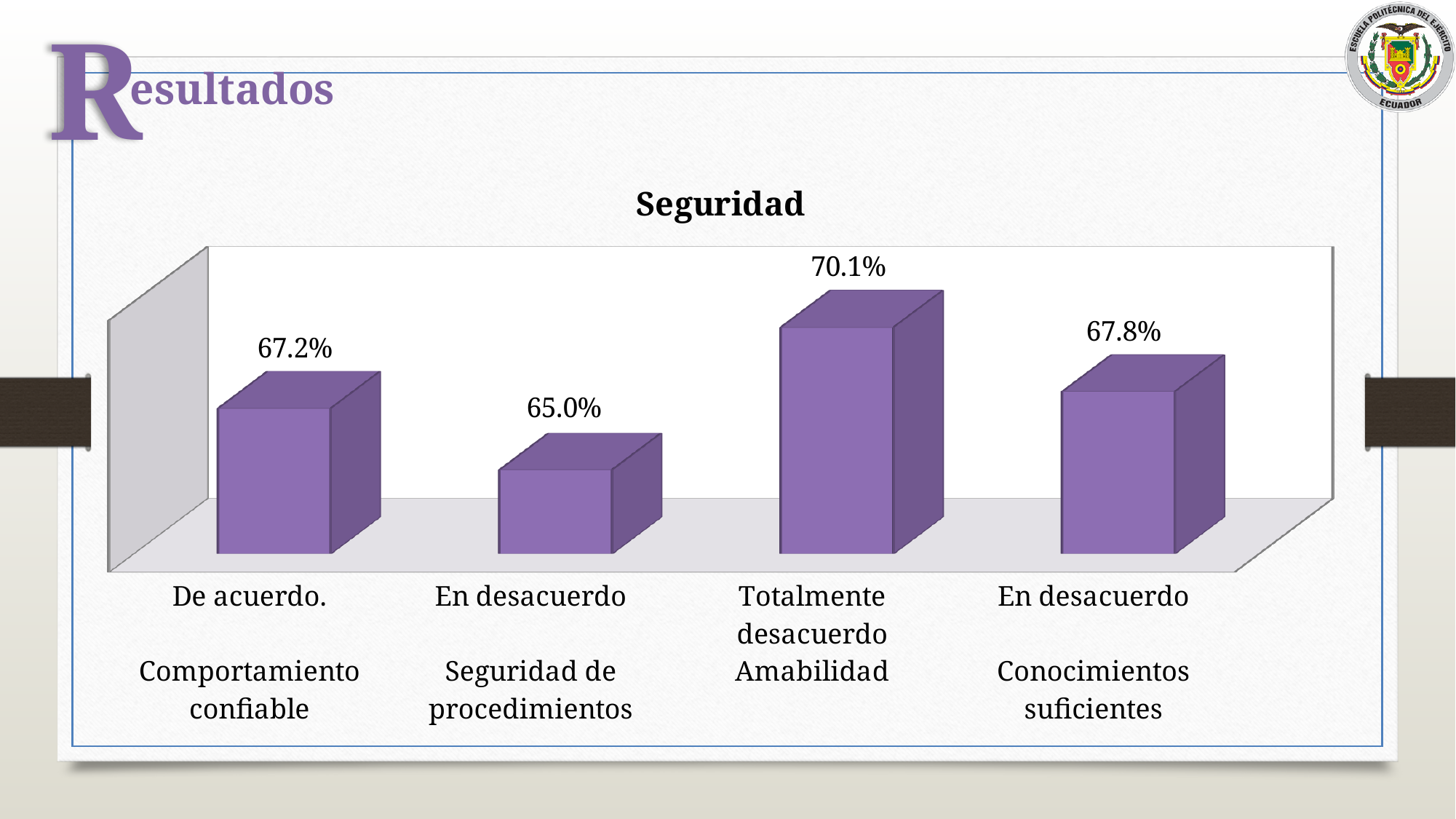
What is the value for Comportamiento confiable? 67.2% Which category has the lowest value? Seguridad de procedimientos Which is larger, the value for Comportamiento confiable or the value for Seguridad de procedimientos? Comportamiento confiable What is the value for Seguridad de procedimientos? 65.0% What is the difference between the values for Conocimientos suficientes and Comportamiento confiable? 0.6% What kind of chart is shown on the slide? Bar chart What is the difference between the values for Amabilidad and Seguridad de procedimientos? 5.1% How many categories are shown in the chart? 4 What is the value for Conocimientos suficientes? 67.8% What is the value for Amabilidad? 70.1% Which category has the highest value? Amabilidad What is the title of the chart? Seguridad